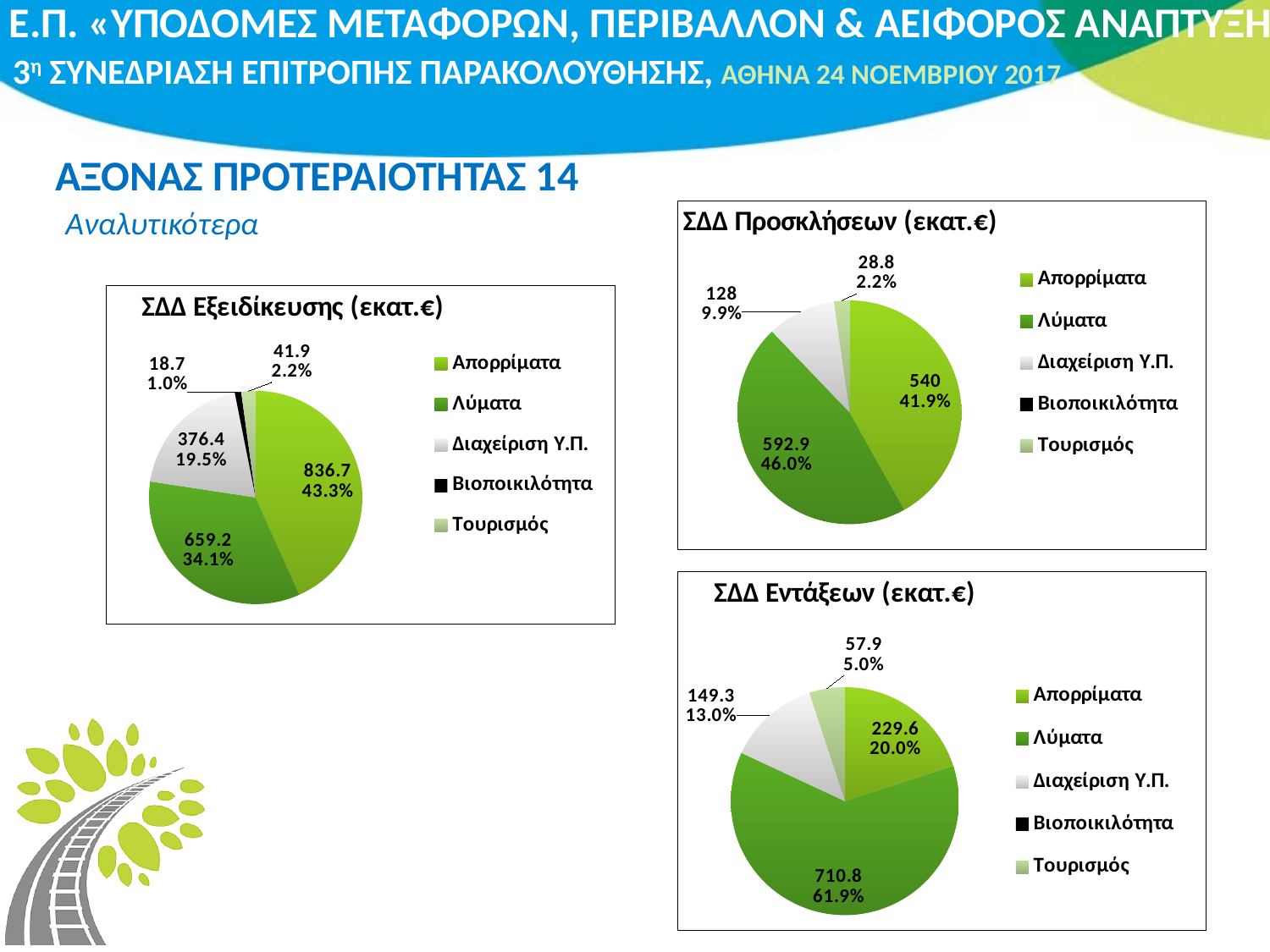
In the chart titled ΣΔΔ Εξειδίκευσης (εκατ.€), what share of the pie does Λύματα represent? 34.1% What type of chart is the chart titled ΣΔΔ Εντάξεων (εκατ.€)? Pie chart In the chart titled ΣΔΔ Προσκλήσεων (εκατ.€), what is the value for Λύματα? 592.9 In the chart titled ΣΔΔ Προσκλήσεων (εκατ.€), which category has the largest slice? Λύματα In the chart titled ΣΔΔ Προσκλήσεων (εκατ.€), what share of the pie does Διαχείριση Υ.Π. represent? 9.9% In the chart titled ΣΔΔ Εντάξεων (εκατ.€), which is larger, the value for Απορρίματα or the value for Διαχείριση Υ.Π.? Απορρίματα In the chart titled ΣΔΔ Εξειδίκευσης (εκατ.€), what is the difference between the values for Απορρίματα and Λύματα? 177.5 In the chart titled ΣΔΔ Εντάξεων (εκατ.€), what share of the pie does Τουρισμός represent? 5.0% How many entries does the legend of the chart titled ΣΔΔ Εξειδίκευσης (εκατ.€) list? 5 In the chart titled ΣΔΔ Εντάξεων (εκατ.€), what is the value for Λύματα? 710.8 In the chart titled ΣΔΔ Εξειδίκευσης (εκατ.€), which category has the smallest slice? Βιοποικιλότητα In the chart titled ΣΔΔ Εξειδίκευσης (εκατ.€), what is the value for Απορρίματα? 836.7